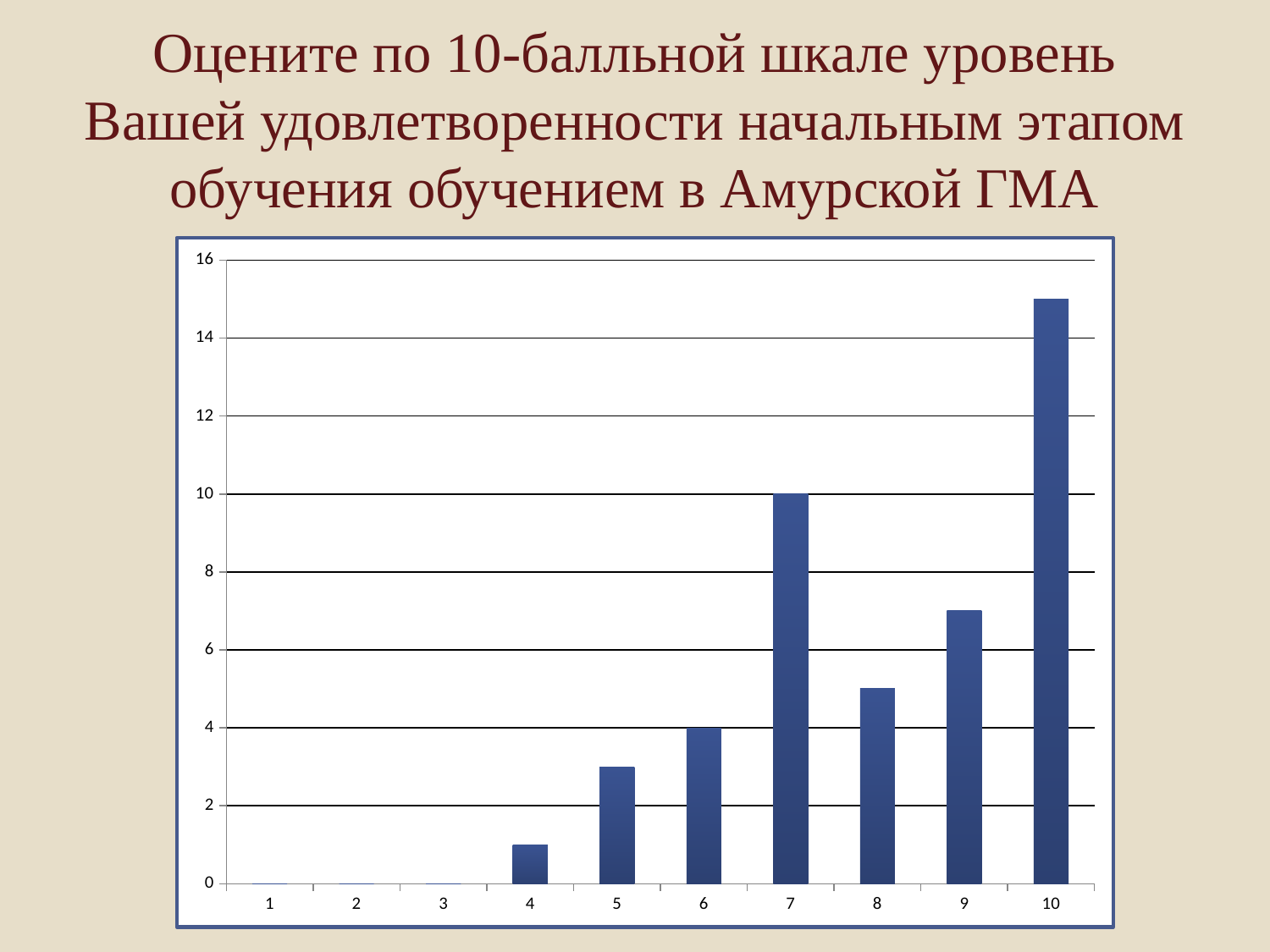
What kind of chart is shown on the slide? bar chart Is the value for category 9 greater or less than 8? less Which is larger, the value for category 7 or the value for category 8? category 7 What is the difference between the values for category 7 and category 6? 6 Which category has the highest bar in the chart? 10 Is the value for category 8 greater or less than 4? greater Is the value for category 10 greater or less than 14? greater What is the value for category 7? 10 How many categories are shown on the x axis of the chart? 10 What is the value for category 6? 4 What is the highest value shown on the y axis of the chart? 16